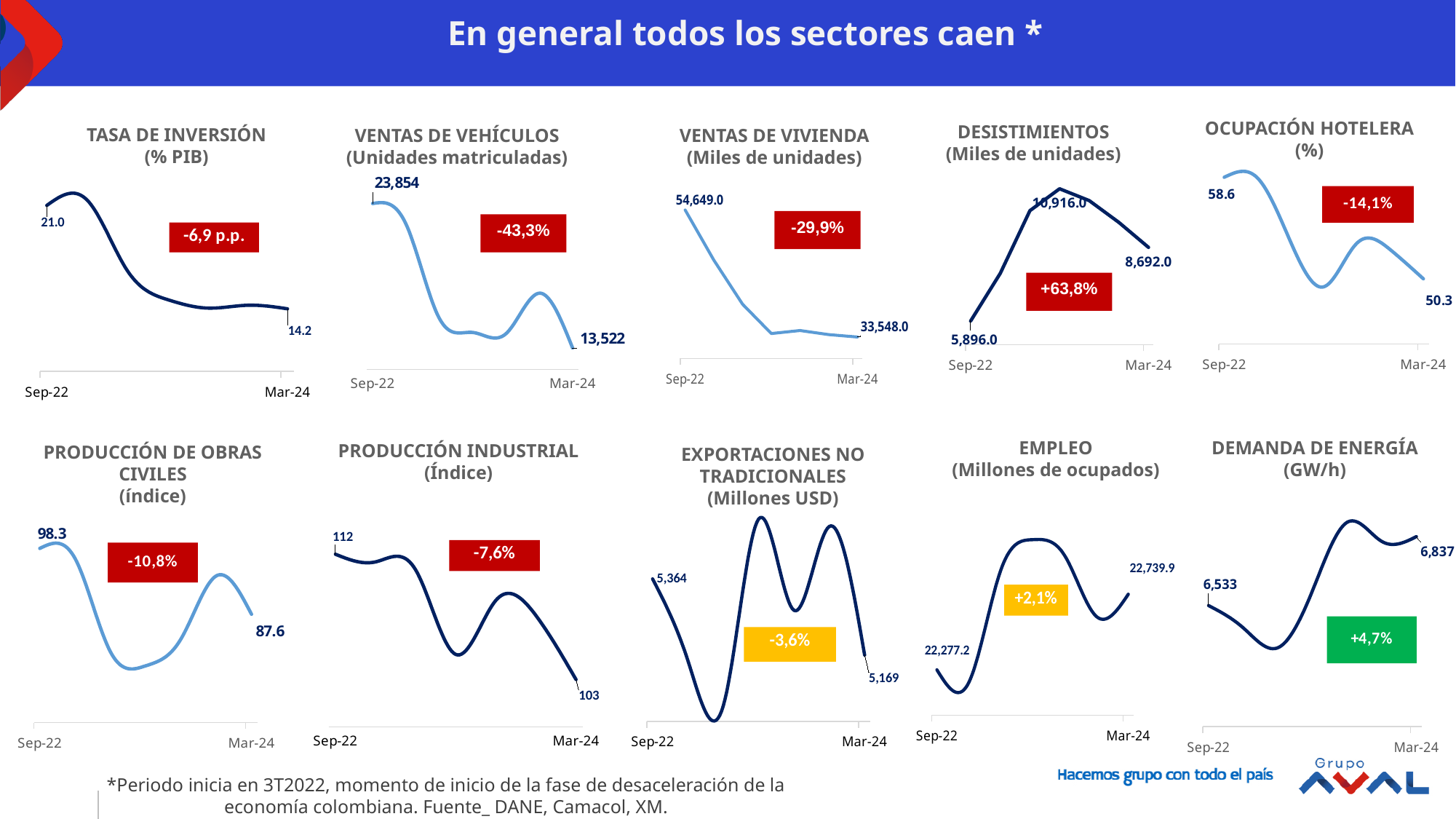
In the 'PRODUCCIÓN DE OBRAS CIVILES' chart, what is the value at Sep-22? 98.3 In the 'EXPORTACIONES NO TRADICIONALES' chart, does the value at Mar-24 end higher or lower than at Sep-22? lower In the 'TASA DE INVERSIÓN (% PIB)' chart, what is the value at Mar-24? 14.2 In the 'OCUPACIÓN HOTELERA (%)' chart, what percentage change is shown in the red box? -14,1% In the 'DEMANDA DE ENERGÍA (GW/h)' chart, what is the value at Mar-24? 6,837 In the 'DESISTIMIENTOS' chart, what is the peak value labelled on the line? 10,916.0 In the 'VENTAS DE VIVIENDA' chart, what is the value at Mar-24? 33,548.0 In the 'PRODUCCIÓN INDUSTRIAL' chart, what is the difference between the Sep-22 value and the Mar-24 value? 9 In the 'VENTAS DE VEHÍCULOS' chart, what is the value at Sep-22? 23,854 In the 'EMPLEO' chart, is the Mar-24 value larger or smaller than the Sep-22 value? larger How many charts are shown on the slide? 10 What type of chart is used for 'PRODUCCIÓN DE OBRAS CIVILES'? line chart